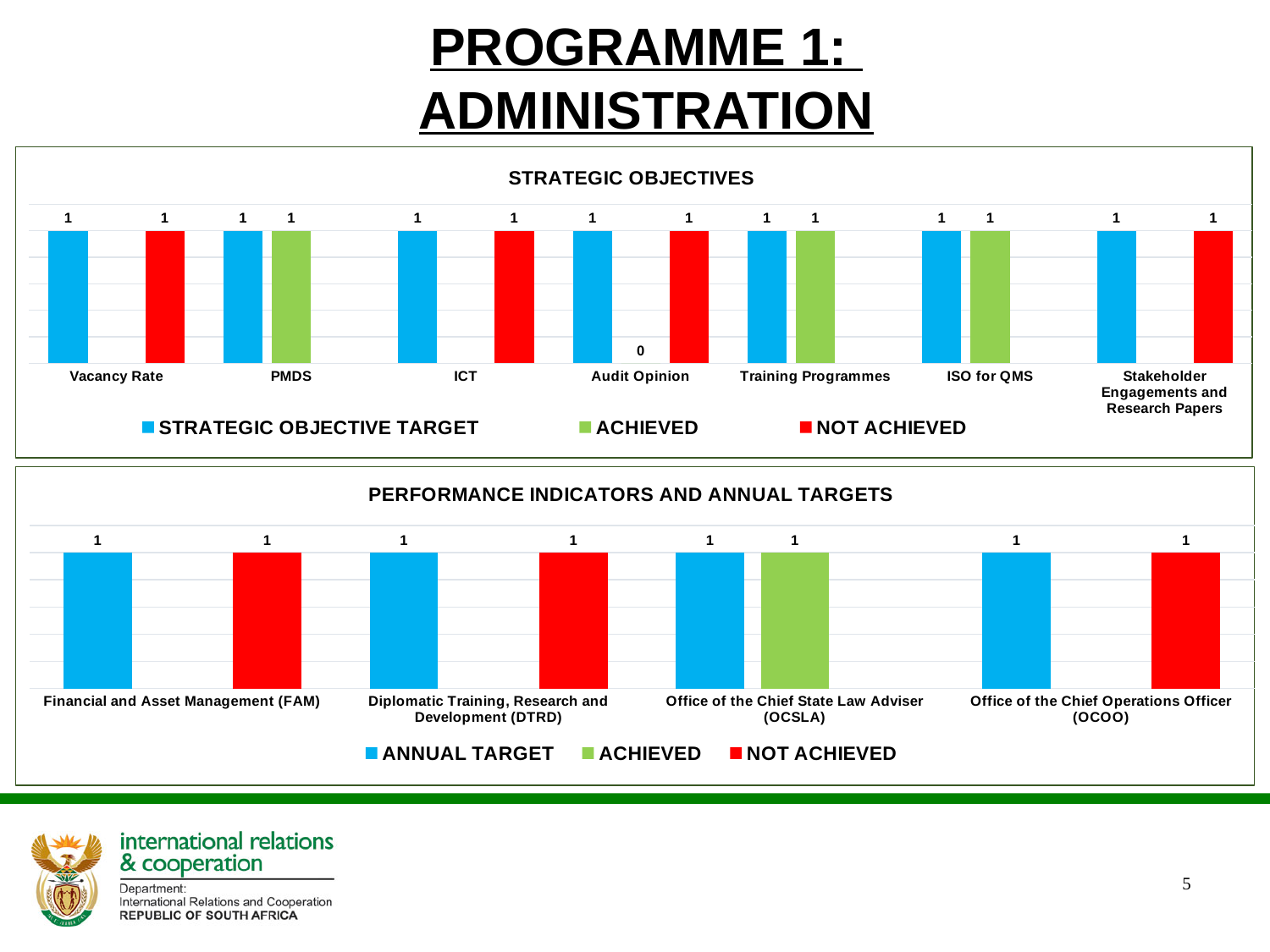
In the PERFORMANCE INDICATORS AND ANNUAL TARGETS chart, how many series does the legend list? 3 In the STRATEGIC OBJECTIVES chart, how many categories are shown on the x axis? 7 In the PERFORMANCE INDICATORS AND ANNUAL TARGETS chart, what is the NOT ACHIEVED value for Financial and Asset Management (FAM)? 1 What is the title of the bottom chart on the slide? PERFORMANCE INDICATORS AND ANNUAL TARGETS In the STRATEGIC OBJECTIVES chart, which series is shown in green according to the legend? ACHIEVED In the STRATEGIC OBJECTIVES chart, how many series does the legend list? 3 In the PERFORMANCE INDICATORS AND ANNUAL TARGETS chart, how many categories are shown on the x axis? 4 In the STRATEGIC OBJECTIVES chart, what is the STRATEGIC OBJECTIVE TARGET value for PMDS? 1 In the STRATEGIC OBJECTIVES chart, what is the ACHIEVED value for Audit Opinion? 0 What kind of chart is the STRATEGIC OBJECTIVES chart? Bar chart In the PERFORMANCE INDICATORS AND ANNUAL TARGETS chart, what is the ACHIEVED value for Office of the Chief State Law Adviser (OCSLA)? 1 In the STRATEGIC OBJECTIVES chart, what is the NOT ACHIEVED value for ICT? 1